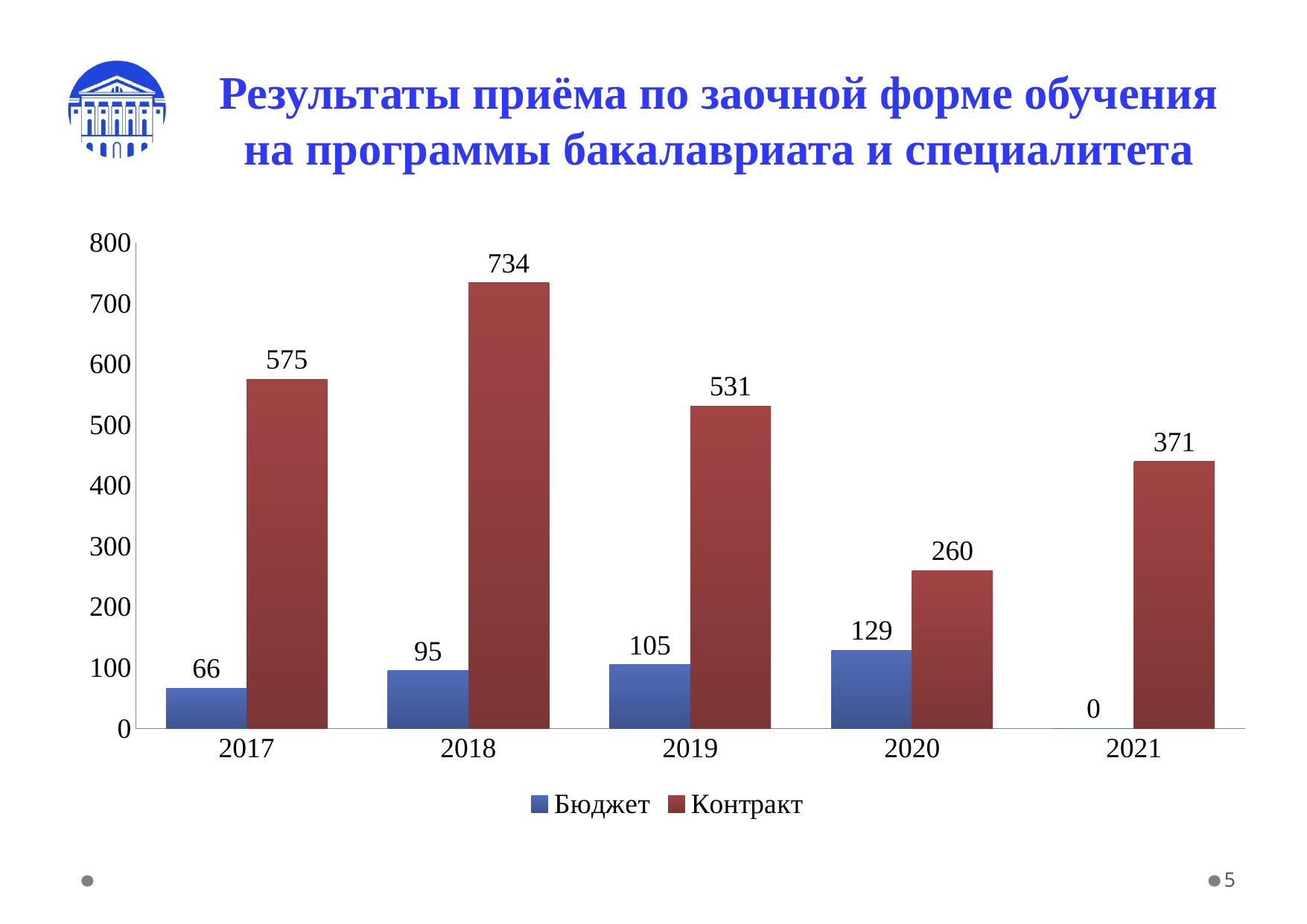
In which year is the Контракт value highest? 2018 Which is larger: the Бюджет value in 2019 or the Бюджет value in 2018? 2019 What is the value for Бюджет in 2021? 0 What is the value for Контракт in 2018? 734 What kind of chart is shown on the slide? bar chart What is the difference between the Контракт and Бюджет values in 2017? 509 In which year is the Контракт value lowest? 2020 How many years are shown on the x axis? 5 What is the value for Бюджет in 2020? 129 What is the difference between the Контракт values in 2018 and 2019? 203 In which year is the Бюджет value highest? 2020 How many series does the legend list? 2